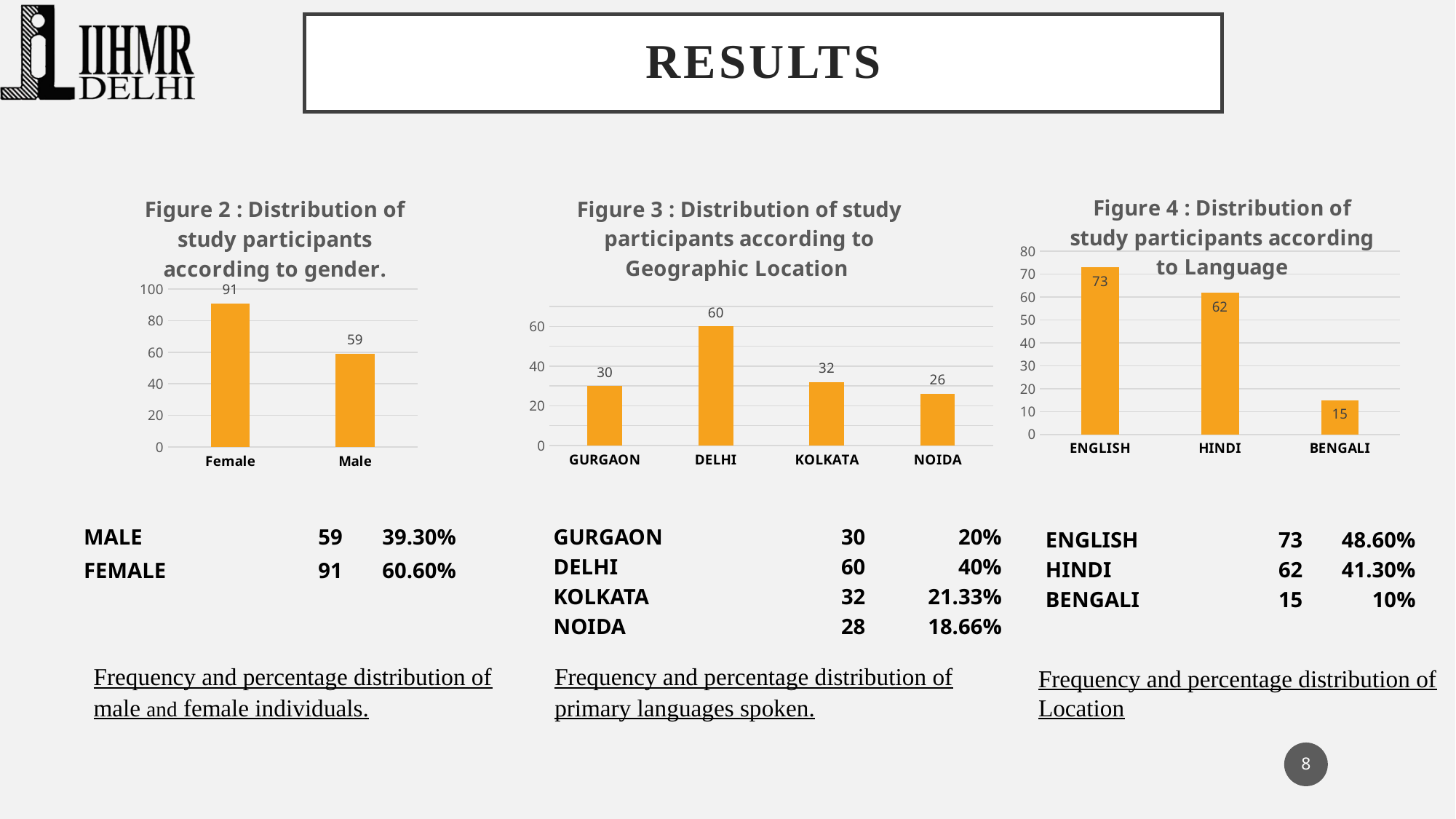
In Figure 2 (Distribution of study participants according to gender), how many categories are shown on the x axis? 2 In Figure 3 (Distribution of study participants according to Geographic Location), which location has the lowest value? NOIDA In Figure 3 (Distribution of study participants according to Geographic Location), how many locations are plotted? 4 In Figure 2 (Distribution of study participants according to gender), what is the difference between the Female and Male values? 32 In Figure 3 (Distribution of study participants according to Geographic Location), what kind of chart is used? Bar chart In Figure 4 (Distribution of study participants according to Language), what is the value for HINDI? 62 In Figure 4 (Distribution of study participants according to Language), do the values rise or fall from left to right along the x axis? Fall In Figure 3 (Distribution of study participants according to Geographic Location), which location has the highest value? DELHI In Figure 2 (Distribution of study participants according to gender), what is the value for Female? 91 In Figure 3 (Distribution of study participants according to Geographic Location), what is the value labelled for KOLKATA? 32 In Figure 4 (Distribution of study participants according to Language), which language has the lowest value? BENGALI In Figure 4 (Distribution of study participants according to Language), what is the difference between the ENGLISH and BENGALI values? 58